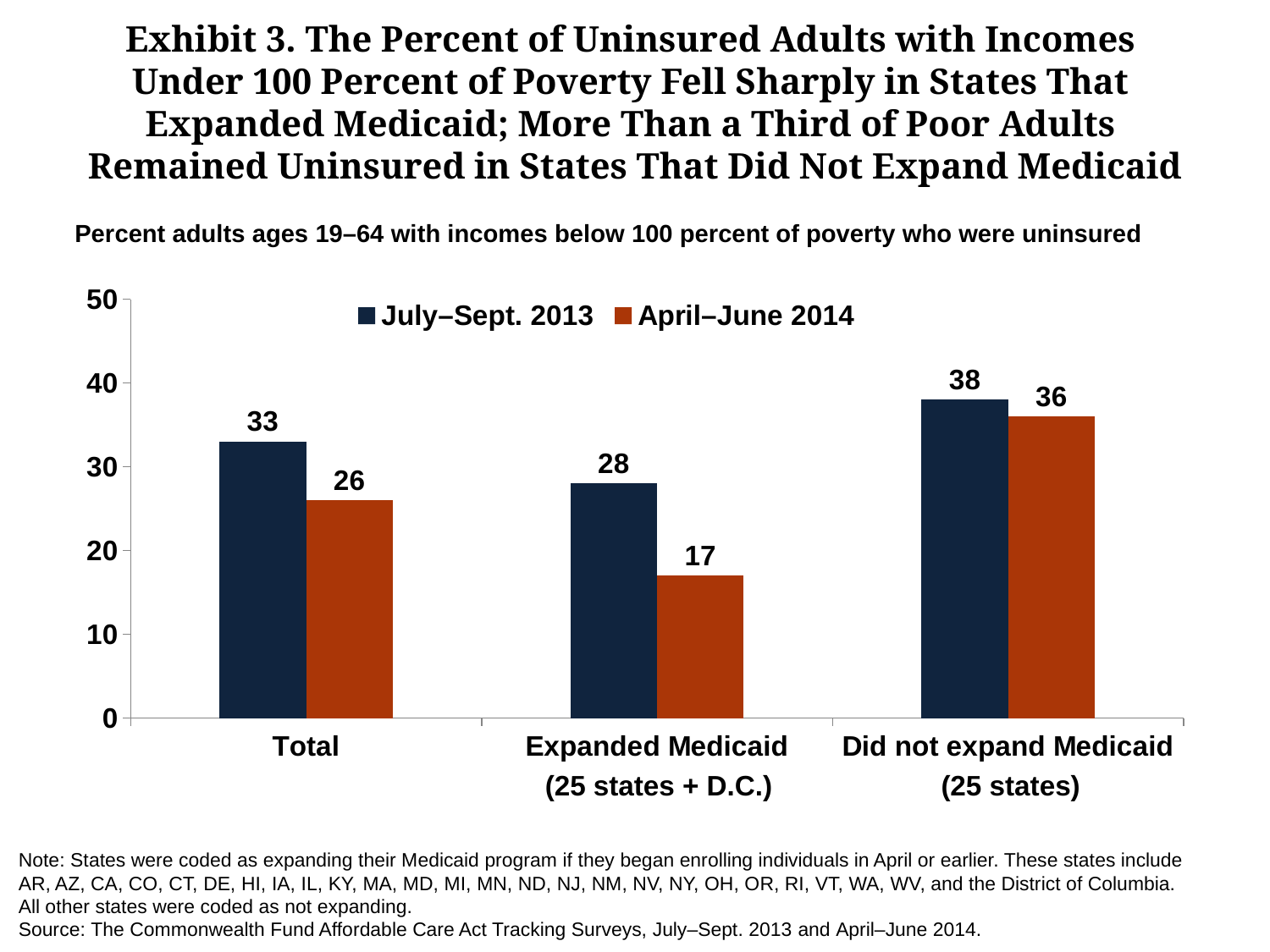
Which category had the highest percent uninsured in April–June 2014? Did not expand Medicaid (25 states) How many series does the legend list? 2 Which is larger: the Total value in July–Sept. 2013 or the Did not expand Medicaid value in April–June 2014? Did not expand Medicaid in April–June 2014 What was the percent uninsured for Did not expand Medicaid (25 states) in July–Sept. 2013? 38 What is the difference between the April–June 2014 values for Did not expand Medicaid and Expanded Medicaid? 19 What kind of chart is shown on the slide? Bar chart What was the percent uninsured for Expanded Medicaid (25 states + D.C.) in April–June 2014? 17 By how many percentage points did the uninsured rate fall between July–Sept. 2013 and April–June 2014 for Expanded Medicaid (25 states + D.C.)? 11 How many categories are shown on the x axis? 3 Which category had the lowest percent uninsured in July–Sept. 2013? Expanded Medicaid (25 states + D.C.) Which series is shown in dark navy blue? July–Sept. 2013 What was the percent of uninsured poor adults in the Total category in July–Sept. 2013? 33